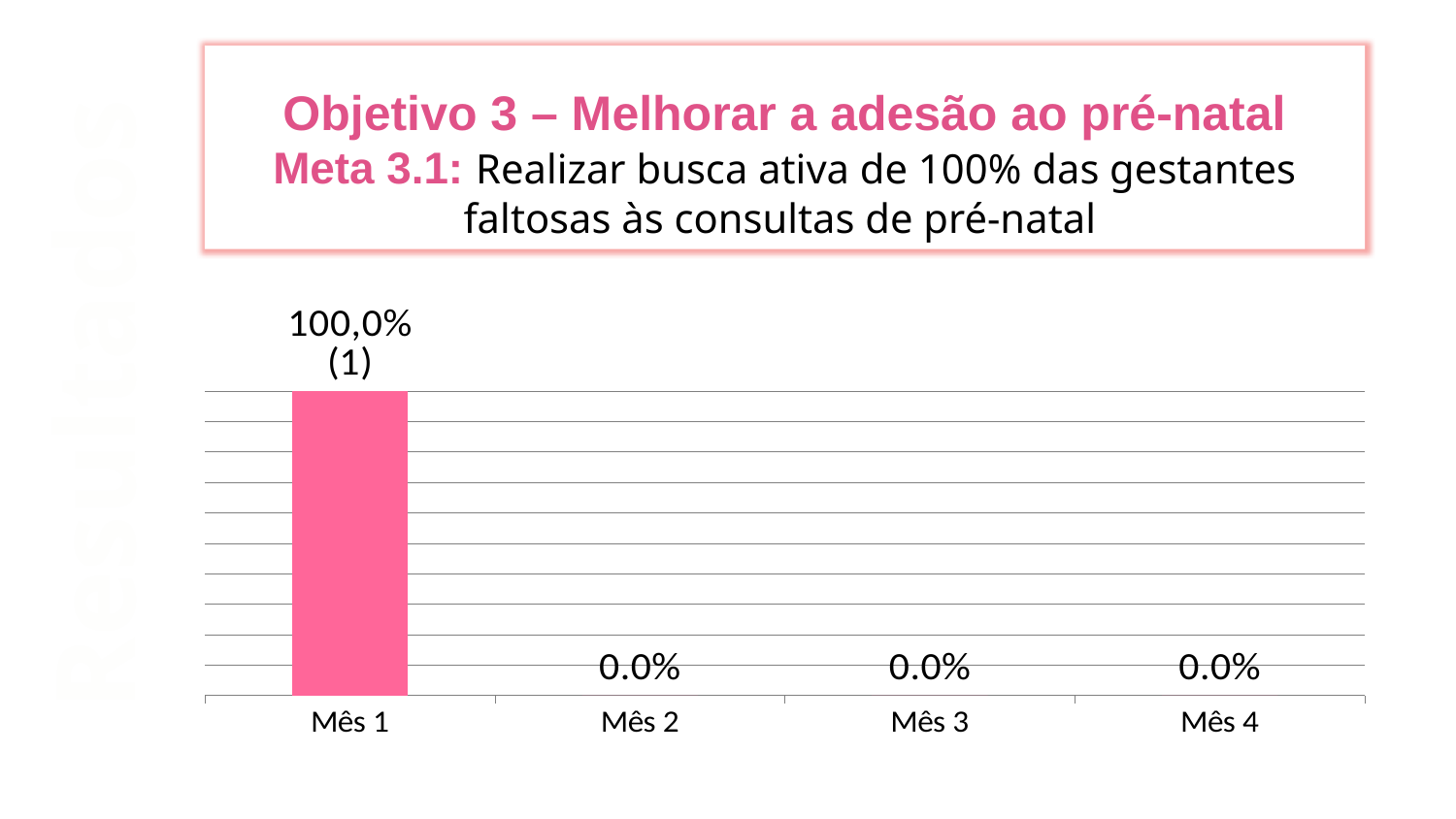
What is the difference between the values for Mês 1 and Mês 3? 100 percentage points What colour is the bar for Mês 1? Pink Which is larger, the value for Mês 1 or the value for Mês 2? Mês 1 Which month has the highest value? Mês 1 What kind of chart is shown on the slide? Bar chart What is the objective stated in the slide title? Objetivo 3 – Melhorar a adesão ao pré-natal What is the value shown for Mês 4? 0.0% What number is shown in parentheses under the Mês 1 data label? (1) What is the value shown for Mês 1? 100,0% What is the value shown for Mês 2? 0.0% Do the values rise or fall from Mês 1 to Mês 4? Fall How many months are shown on the x axis? 4